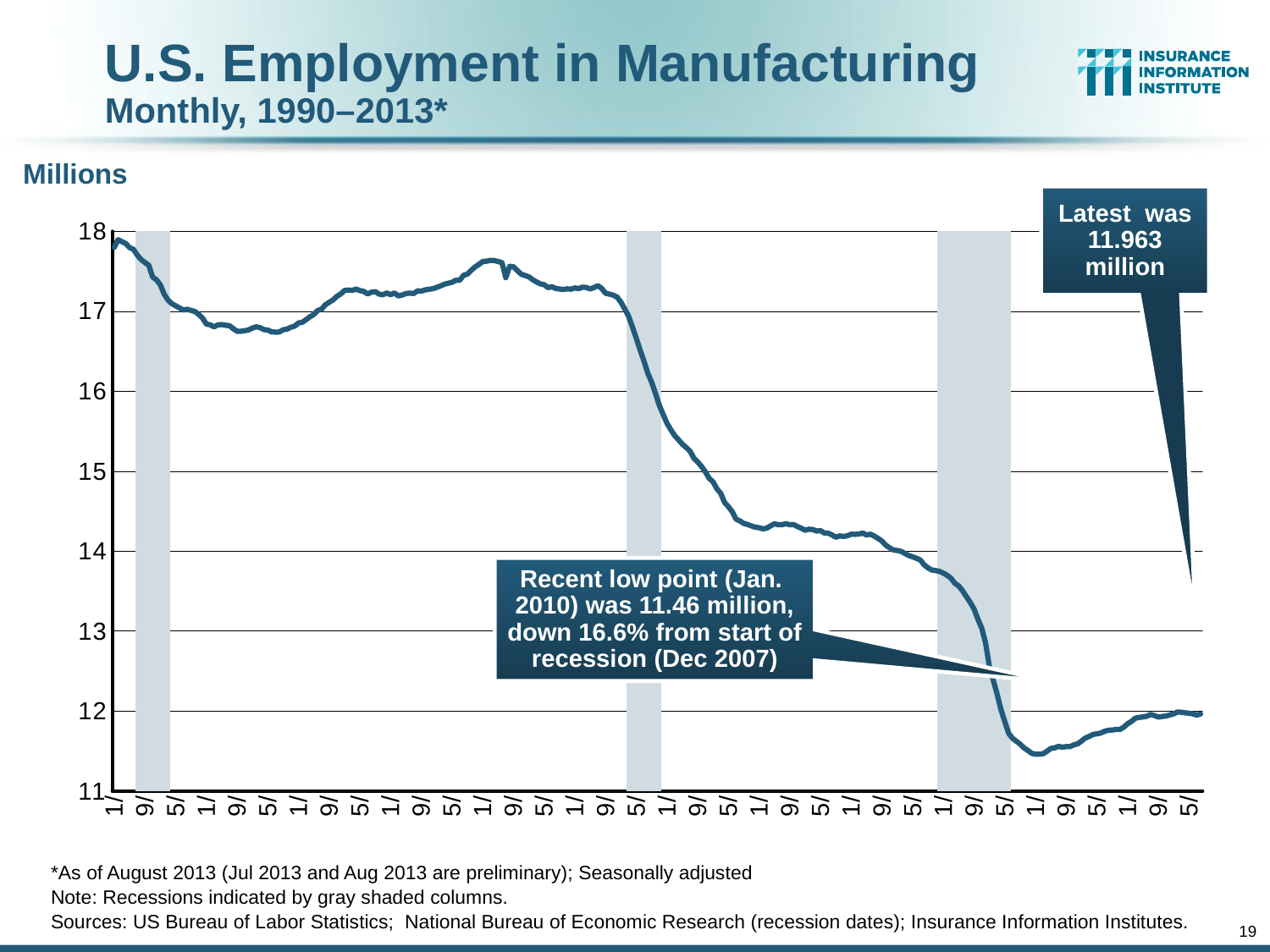
What kind of chart is shown on the slide? Line chart How many gray shaded recession columns appear on the chart? 3 How much higher is the latest value (11.963 million) than the January 2010 low point (11.46 million)? 0.503 million What do the gray shaded columns on the chart indicate? Recessions According to the callout, what was the latest value of U.S. manufacturing employment? 11.963 million Overall, does manufacturing employment rise or fall from 1990 to 2013? Fall When did the recent low point in manufacturing employment occur? January 2010 By what percentage was the January 2010 low point down from the start of the recession in December 2007? 16.6% Which is larger, the latest value or the January 2010 low point? The latest value (11.963 million) Is the highest point on the line greater or less than 17 million? greater Is the value at the start of the series in 1990 greater or less than 17 million? greater What was the recent low point of manufacturing employment in January 2010? 11.46 million